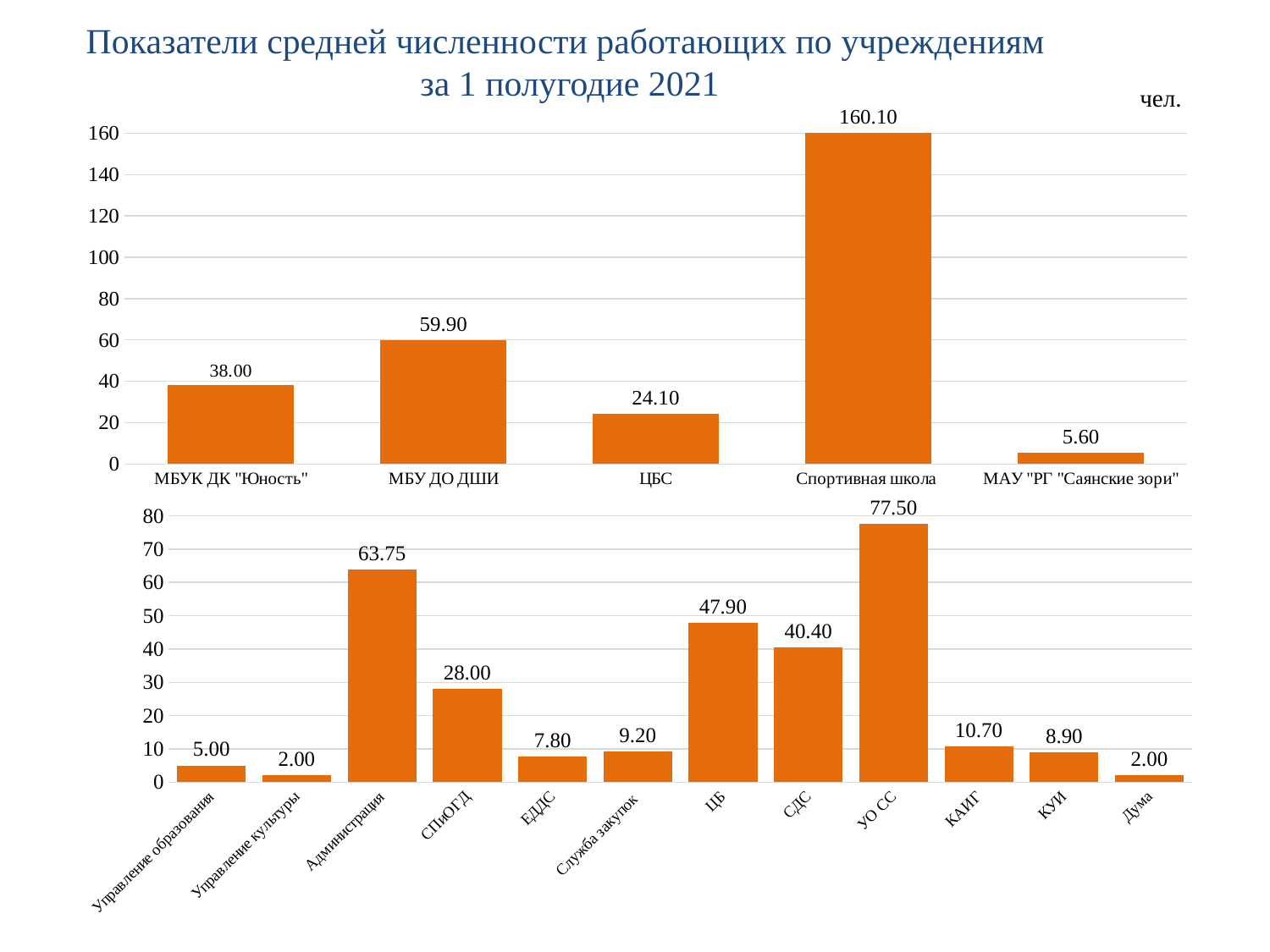
In the bottom chart, which is larger, ЦБ or СДС? ЦБ In the bottom chart, which category has the highest value? УО СС In the bottom chart, how many categories are shown? 12 What kind of chart is the top chart? Bar chart In the top chart, what is the value for ЦБС? 24.10 In the bottom chart, what is the difference between УО СС and СПиОГД? 49.50 In the top chart, how many categories are shown? 5 In the top chart, what is the difference between МБУ ДО ДШИ and МБУК ДК "Юность"? 21.90 In the bottom chart, what is the value for Администрация? 63.75 In the top chart, what is the value for Спортивная школа? 160.10 In the bottom chart, what is the value for КАИГ? 10.70 In the top chart, which category has the lowest value? МАУ "РГ "Саянские зори"